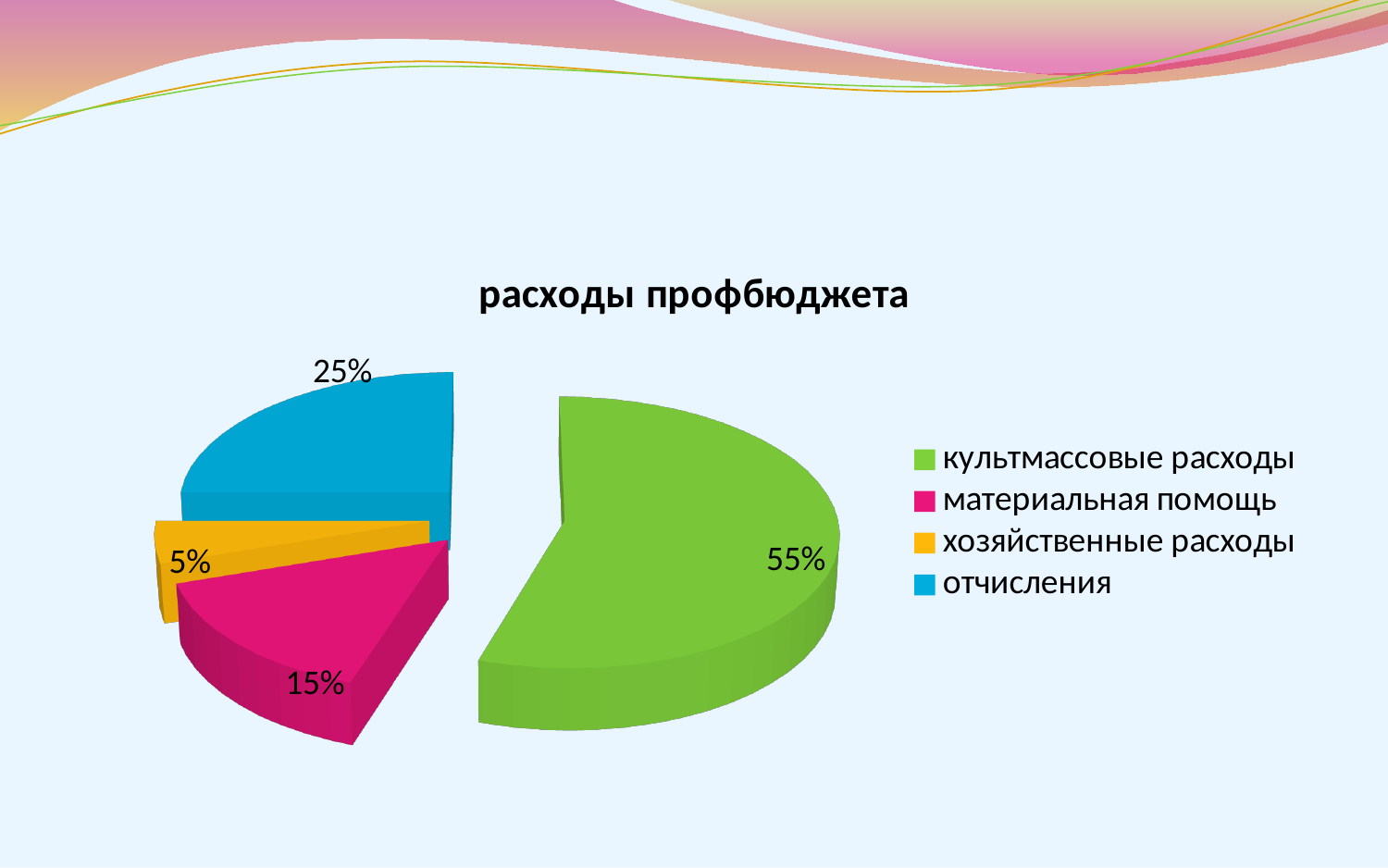
What type of chart is shown on the slide? Pie chart What is the value shown for материальная помощь? 15% What is the value shown for хозяйственные расходы? 5% What share of the pie does культмассовые расходы take? 55% What is the value shown for отчисления? 25% Which category has the largest slice? культмассовые расходы What is the difference between the shares of культмассовые расходы and отчисления? 30% Which is larger, the share for отчисления or the share for материальная помощь? отчисления How many categories does the legend list? 4 What is the title of the chart? расходы профбюджета Which category has the smallest slice? хозяйственные расходы What colour is the slice for отчисления? Blue